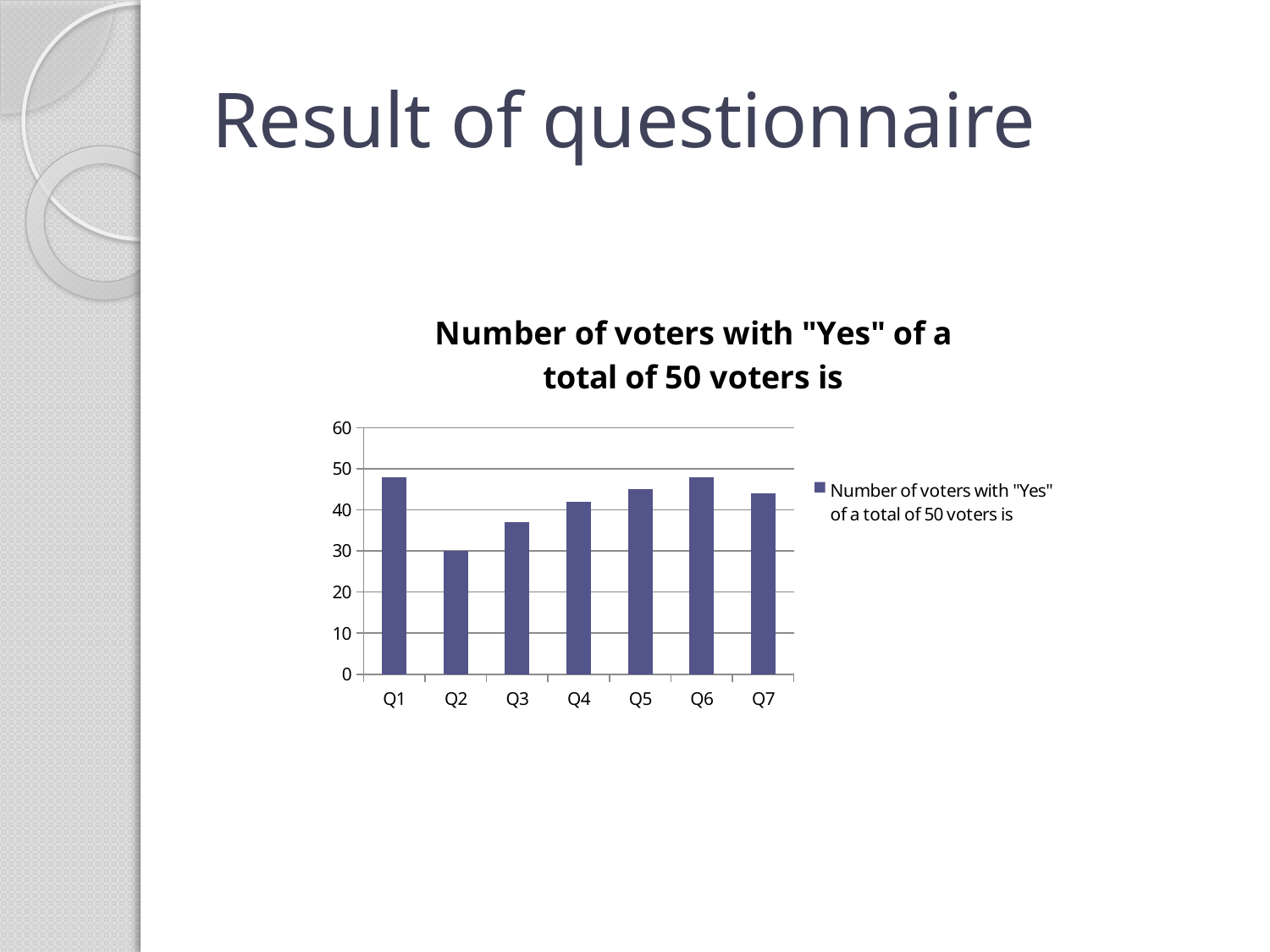
Which question has the lowest number of voters with "Yes"? Q2 Is the value for Q1 greater or less than 40? greater How many categories are shown on the x axis of the chart? 7 What kind of chart is shown on the slide? bar chart Which has more voters with "Yes", Q1 or Q2? Q1 Which has more voters with "Yes", Q3 or Q5? Q5 Is the value for Q2 greater or less than 40? less How many series does the chart's legend list? 1 Is the value for Q2 greater or less than 20? greater What is the title of the chart? Number of voters with "Yes" of a total of 50 voters is